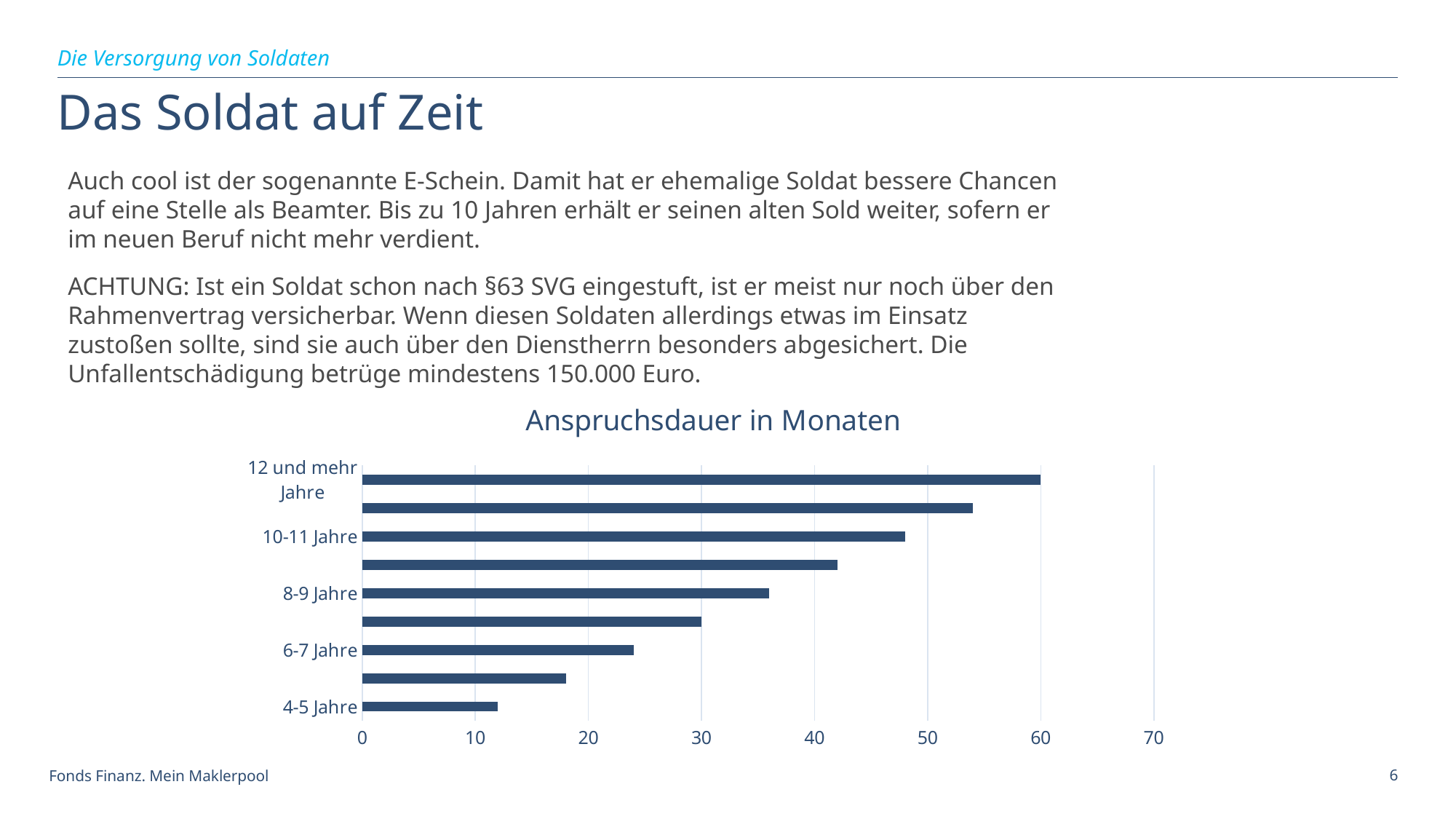
Do the values rise or fall as the years of service increase from '4-5 Jahre' to '12 und mehr Jahre'? rise Which labelled category has the highest value in the chart? 12 und mehr Jahre How many bars are plotted in the chart? 9 Which labelled category has the lowest value in the chart? 4-5 Jahre Which is larger, the value for '8-9 Jahre' or the value for '6-7 Jahre'? 8-9 Jahre What is the value for '12 und mehr Jahre' in the chart? 60 What kind of chart is shown on the slide? bar chart Is the value for '8-9 Jahre' greater or less than 30? greater Is the value for '6-7 Jahre' greater or less than 20? greater Is the value for '4-5 Jahre' greater or less than 20? less What is the title of the chart? Anspruchsdauer in Monaten